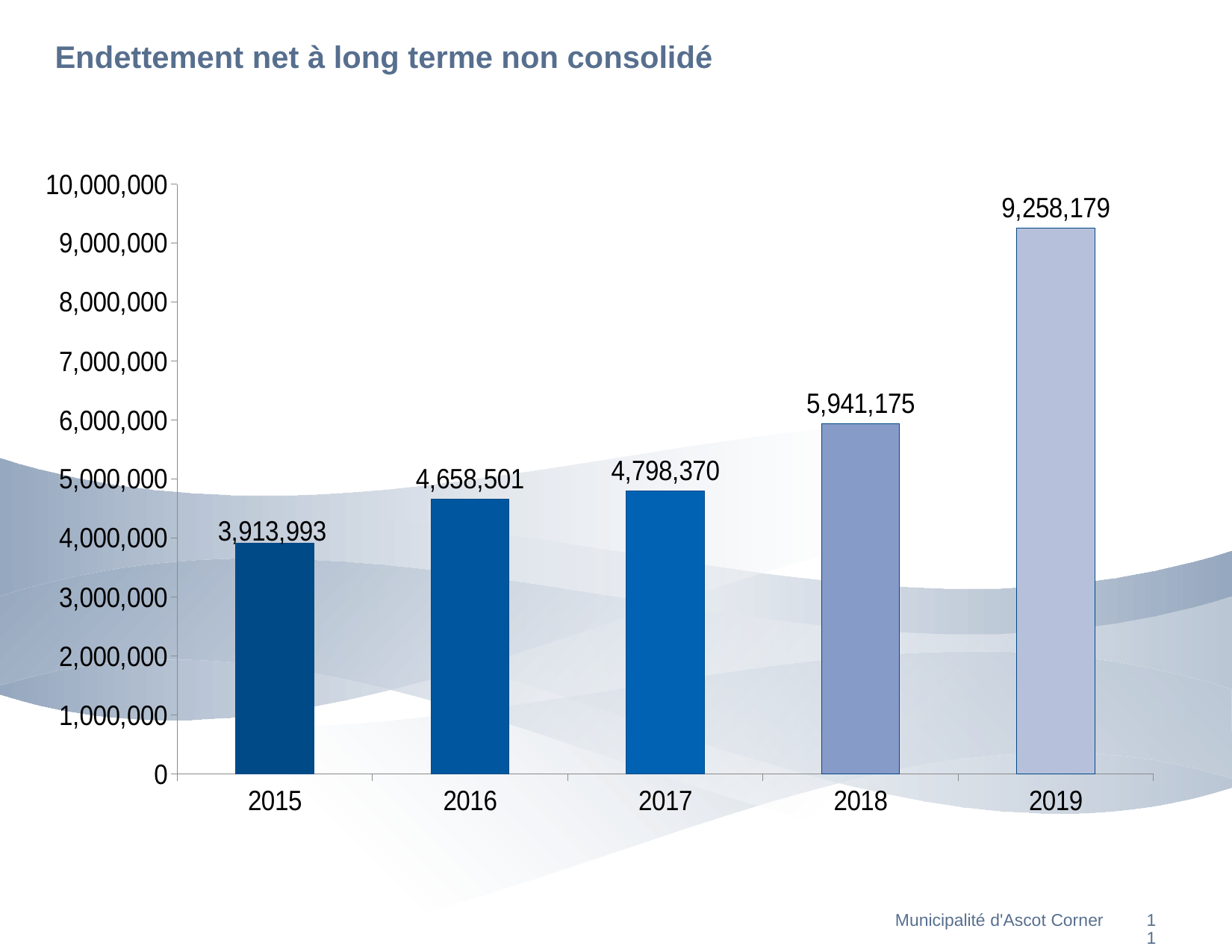
What is the difference between the values for 2019 and 2018? 3,317,004 Is the value for 2018 greater or less than 5,000,000? greater What is the value for 2015? 3,913,993 What is the value for 2017? 4,798,370 Do the values rise or fall from 2015 to 2019? rise Which year has the lowest value? 2015 What is the difference between the values for 2016 and 2015? 744,508 Which year has the highest value? 2019 What kind of chart is shown on the slide? bar chart Which is larger, the value for 2018 or the value for 2017? 2018 What is the value for 2019? 9,258,179 How many years are shown on the x axis? 5